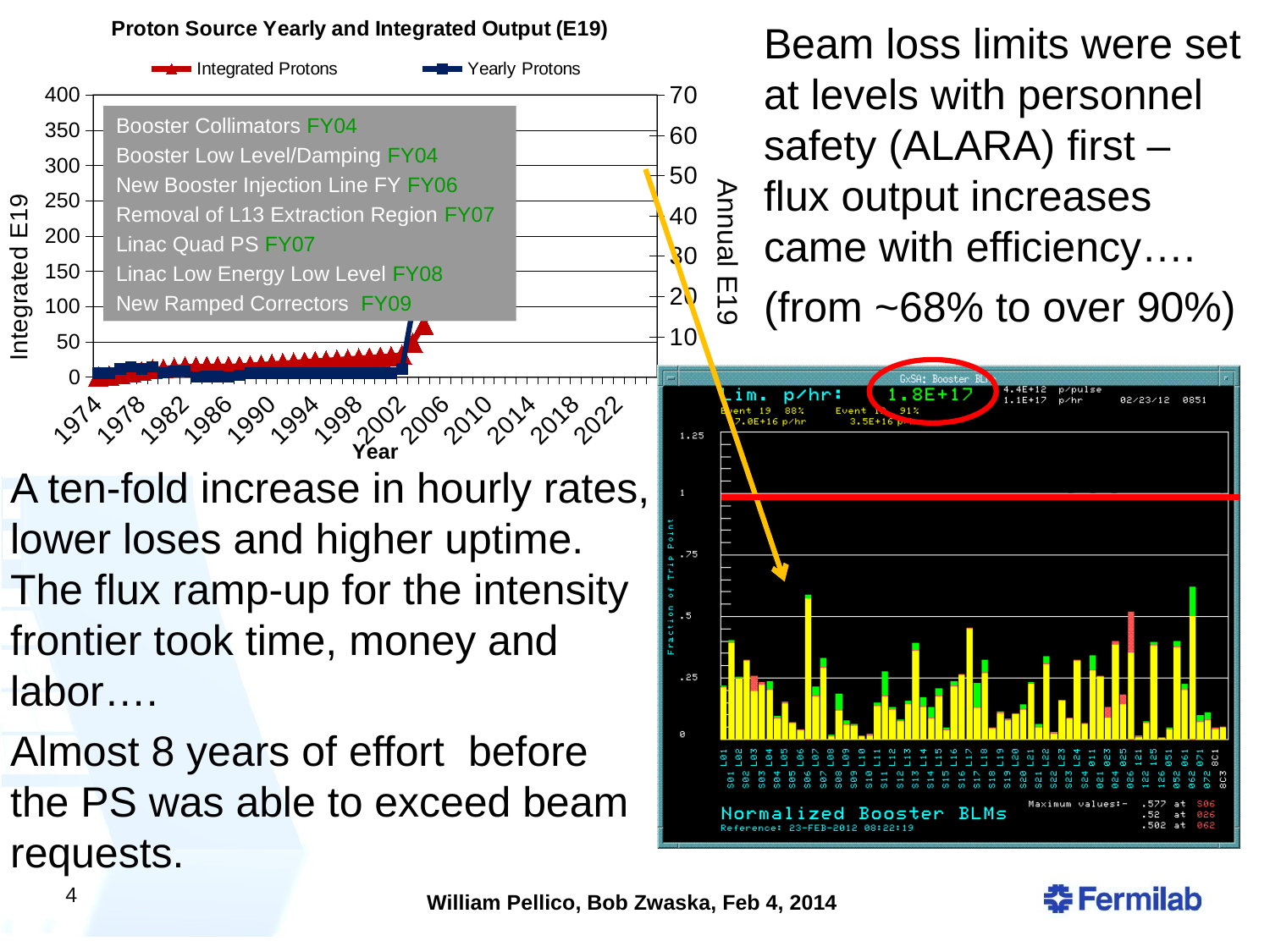
What is the title of the chart on the left of the slide? Proton Source Yearly and Integrated Output (E19) What are the two series named in the legend of the Proton Source Yearly and Integrated Output chart? Integrated Protons and Yearly Protons In the Proton Source Yearly and Integrated Output chart, do the Integrated Protons values rise or fall as the years increase? rise How many series does the legend of the Proton Source Yearly and Integrated Output chart list? 2 In the Proton Source Yearly and Integrated Output chart, is the Integrated Protons value for 1990 greater or less than 100? less What kind of chart is the Normalized Booster BLMs display in the lower right of the slide? bar chart How many year labels are shown on the x axis of the Proton Source Yearly and Integrated Output chart? 13 In the Proton Source Yearly and Integrated Output chart, which year has the larger Integrated Protons value, 1980 or 2004? 2004 In the Proton Source Yearly and Integrated Output chart, is the Integrated Protons value for 1978 greater or less than 50? less What kind of chart is the Proton Source Yearly and Integrated Output chart? line chart In the Proton Source Yearly and Integrated Output chart, is the Yearly Protons value for 1994 greater or less than 30 on the Annual E19 axis? less